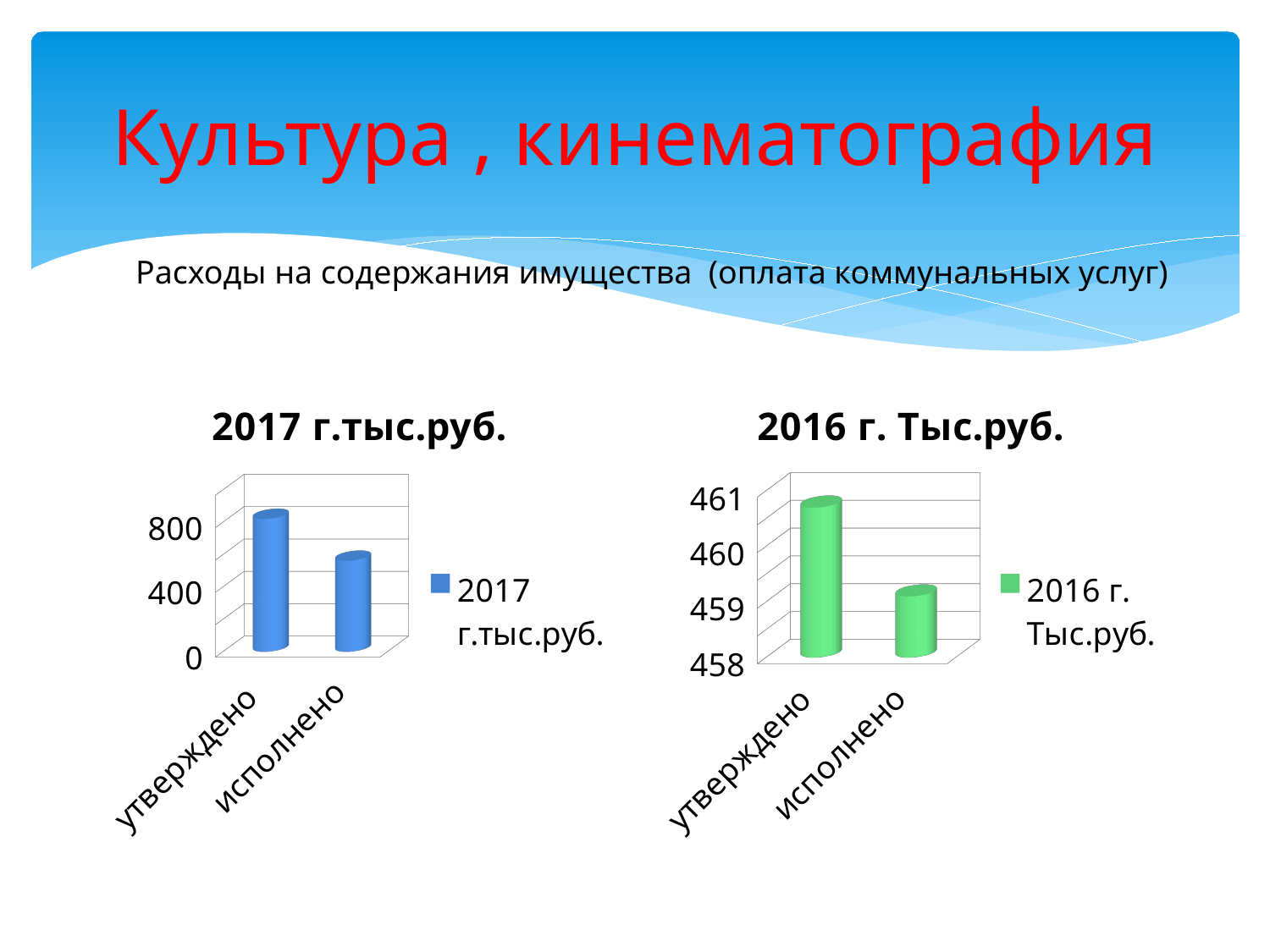
In the chart titled "2016 г. Тыс.руб.", which category has the highest value? утверждено In the chart titled "2016 г. Тыс.руб.", is the value for исполнено greater or less than 460? less In the chart titled "2017 г.тыс.руб.", which category has the lowest value? исполнено How many series does the legend of the chart titled "2016 г. Тыс.руб." list? 1 In the chart titled "2017 г.тыс.руб.", which category has the highest value? утверждено In the chart titled "2016 г. Тыс.руб.", is the value for утверждено greater or less than 460? greater What is the legend entry of the chart titled "2016 г. Тыс.руб."? 2016 г. Тыс.руб. In the chart titled "2016 г. Тыс.руб.", which is larger, утверждено or исполнено? утверждено How many categories are shown on the x axis of the chart titled "2017 г.тыс.руб."? 2 In the chart titled "2017 г.тыс.руб.", is the value for исполнено greater or less than 400? greater What kind of chart is the chart titled "2017 г.тыс.руб."? bar chart